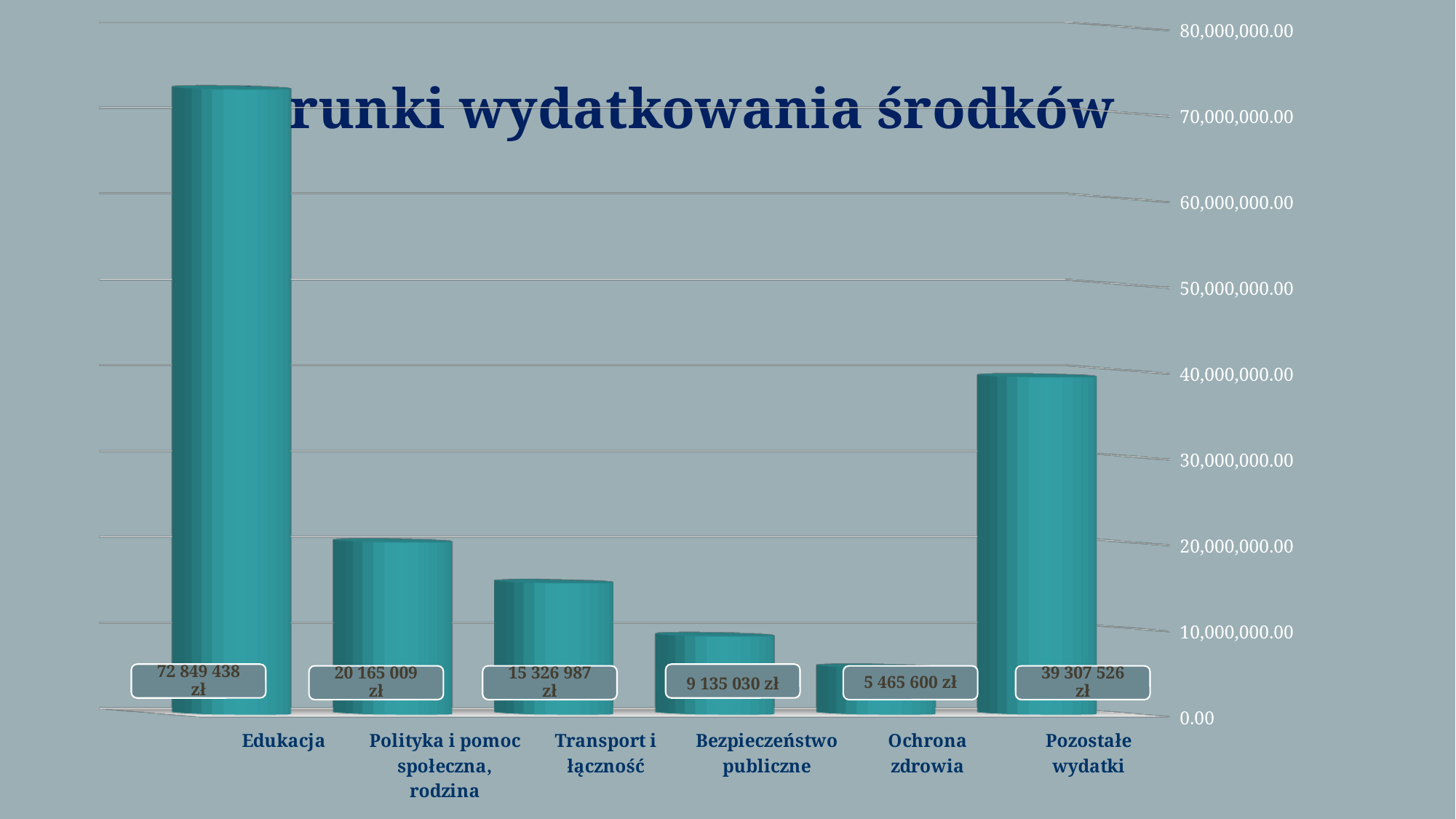
What is the value for Transport i łączność? 15 326 987 zł Which category has the lowest value? Ochrona zdrowia What is the difference between the values for Bezpieczeństwo publiczne and Ochrona zdrowia? 3 669 430 zł What is the value for Ochrona zdrowia? 5 465 600 zł How many categories are shown on the chart? 6 What is the value for Edukacja? 72 849 438 zł What kind of chart is shown on the slide? bar chart Is the value for Edukacja greater or less than 70,000,000.00? greater What is the difference between the values for Edukacja and Pozostałe wydatki? 33 541 912 zł What is the value for Pozostałe wydatki? 39 307 526 zł Which is larger, the value for Polityka i pomoc społeczna, rodzina or the value for Transport i łączność? Polityka i pomoc społeczna, rodzina Which category has the highest value? Edukacja